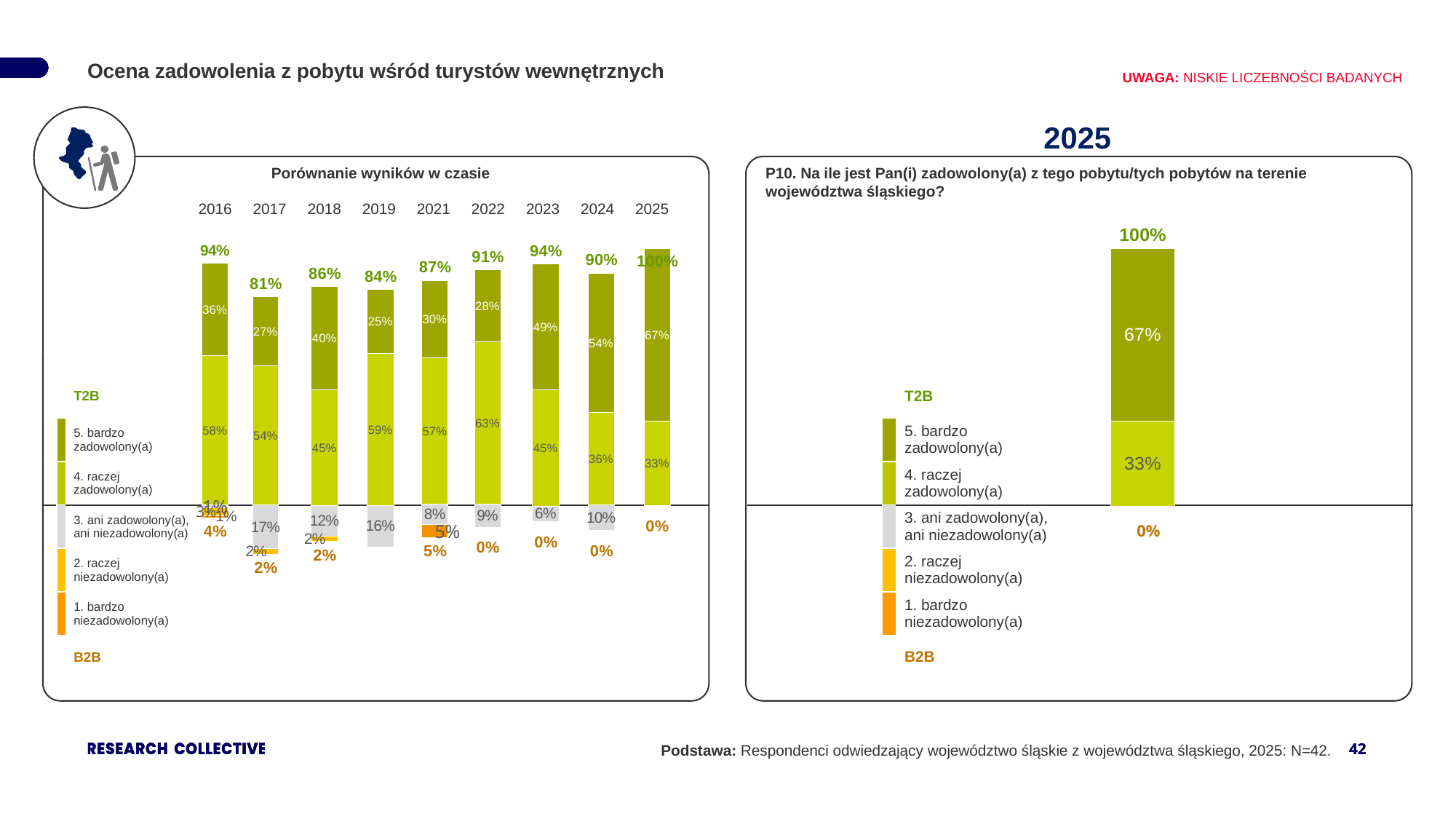
In the left chart 'Porównanie wyników w czasie', what is the difference between the T2B values for 2016 and 2017? 13 percentage points In the left chart 'Porównanie wyników w czasie', which year has the lowest T2B value? 2017 How many years are shown in the left chart 'Porównanie wyników w czasie'? 9 In the left chart 'Porównanie wyników w czasie', what is the value of '3. ani zadowolony(a), ani niezadowolony(a)' for 2017? 17% In the left chart 'Porównanie wyników w czasie', what is the T2B value for 2025? 100% In the right chart for 2025, what is the B2B value? 0% How many series does the legend of the left chart 'Porównanie wyników w czasie' list? 5 In the left chart 'Porównanie wyników w czasie', which year has the higher T2B value, 2023 or 2024? 2023 In the left chart 'Porównanie wyników w czasie', which year has the highest T2B value? 2025 In the right chart for 2025, what share of respondents answered '5. bardzo zadowolony(a)'? 67% In the left chart 'Porównanie wyników w czasie', does the '5. bardzo zadowolony(a)' share rise or fall from 2022 to 2025? Rise What kind of chart is the left chart 'Porównanie wyników w czasie'? Stacked bar chart